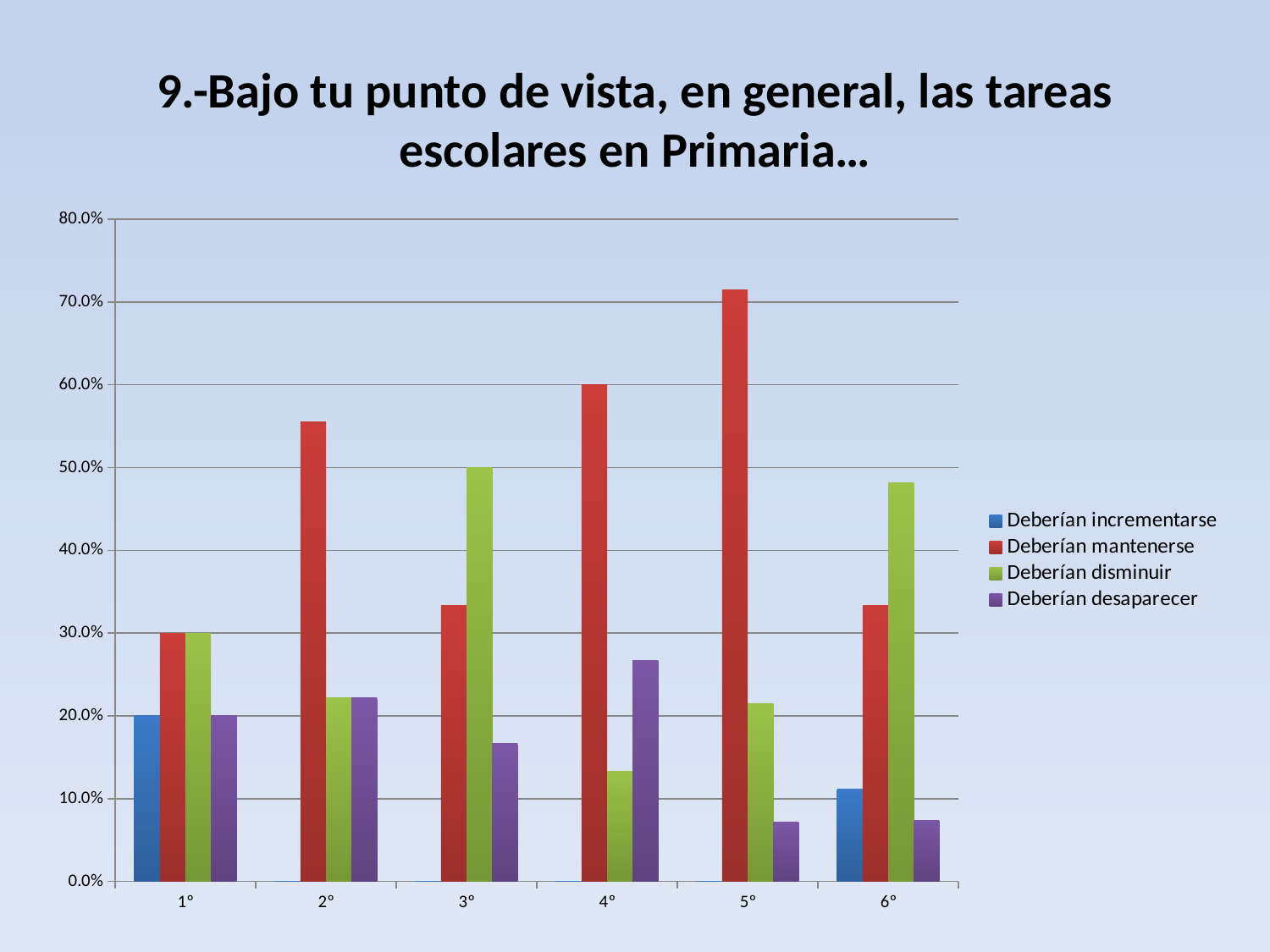
What is the value for Deberían disminuir in 3°? 50.0% What is the value for Deberían incrementarse in 1°? 20.0% Which colour represents Deberían desaparecer in the legend? purple What is the value for Deberían mantenerse in 1°? 30.0% Is the value for Deberían mantenerse in 5° greater or less than 70.0%? greater What type of chart is shown on the slide? bar chart How many series does the legend list? 4 Which category has the highest value for Deberían mantenerse? 5° What is the value for Deberían mantenerse in 4°? 60.0% Which is larger in 6°: Deberían disminuir or Deberían mantenerse? Deberían disminuir How many categories are shown on the x axis? 6